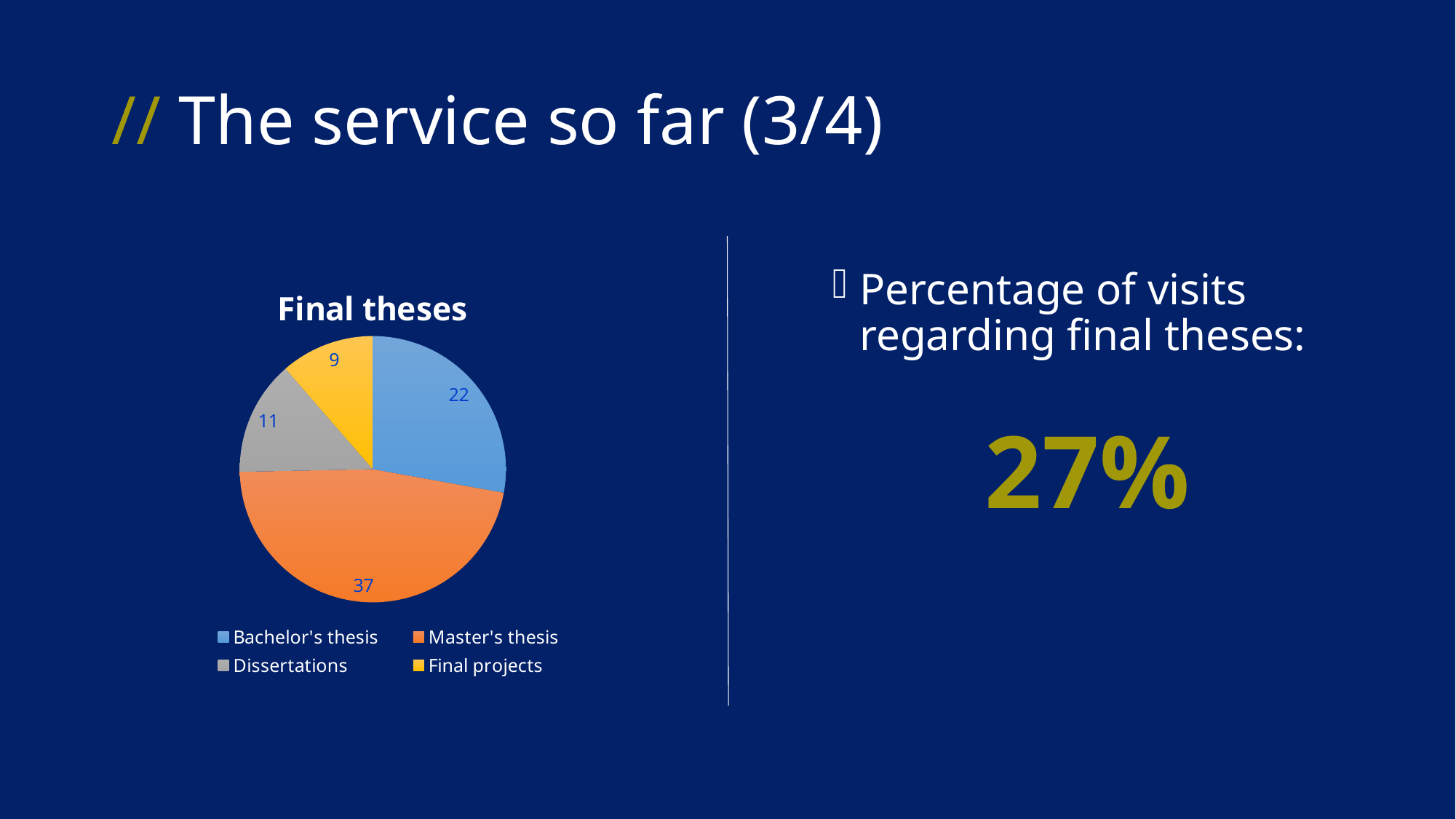
What is the value for Final projects in the Final theses pie chart? 9 What type of chart is shown on the slide? Pie chart What is the value for Bachelor's thesis in the Final theses pie chart? 22 What is the value for Dissertations in the Final theses pie chart? 11 What is the title of the chart? Final theses Which category has the largest slice in the Final theses pie chart? Master's thesis What is the total of all slices in the Final theses pie chart? 79 How many categories does the Final theses pie chart show? 4 What is the value for Master's thesis in the Final theses pie chart? 37 Which is larger, the value for Dissertations or the value for Final projects? Dissertations Which category has the smallest slice in the Final theses pie chart? Final projects What is the difference between the values for Master's thesis and Bachelor's thesis? 15